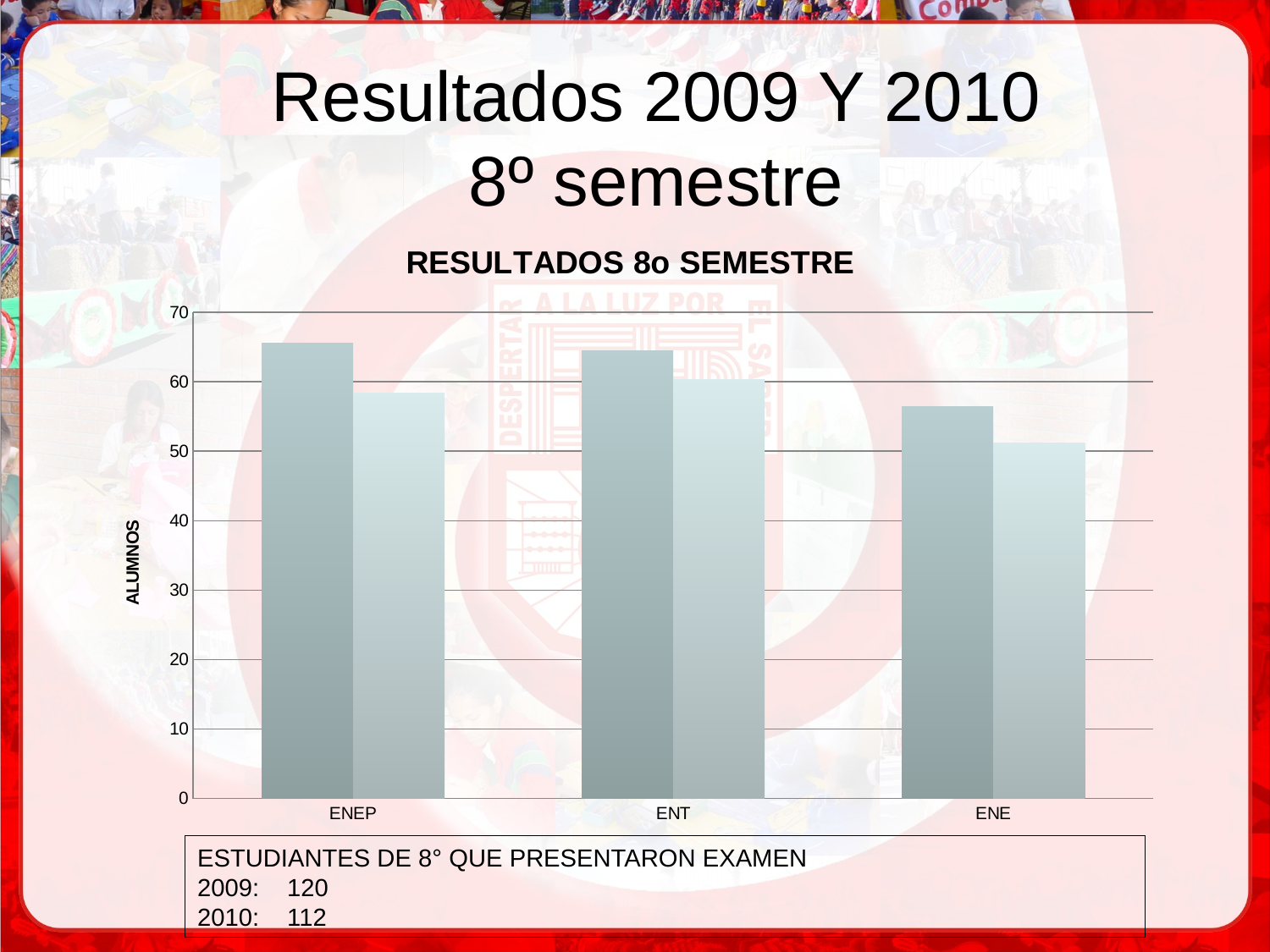
Is the value of the second (lighter) bar for ENE greater or less than 40? greater What is the label on the vertical axis of the chart? ALUMNOS Which category has the lowest value for the first (darker) bar? ENE What kind of chart is shown on the slide? bar chart Is the value of the first (darker) bar for ENEP greater or less than 60? greater Which is larger, the first (darker) bar for ENEP or the first (darker) bar for ENE? ENEP Is the value of the second (lighter) bar for ENEP greater or less than 60? less What is the title of the chart? RESULTADOS 8o SEMESTRE Do the values of the first (darker) bars rise or fall from ENEP to ENE? fall How many categories are shown on the x axis of the chart? 3